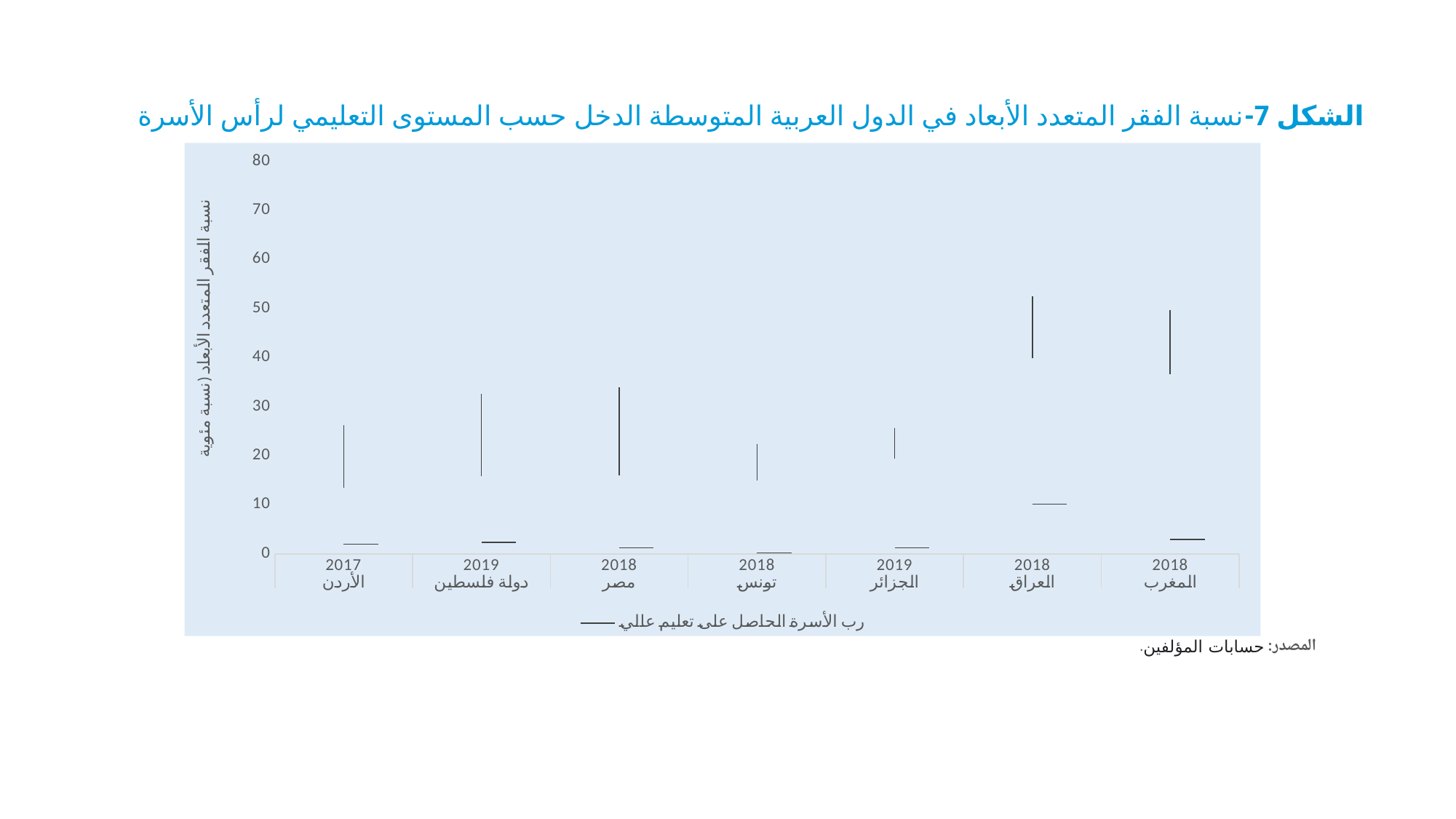
How many country categories are shown on the x axis of the chart? 7 What is the title of the chart? الشكل 7- نسبة الفقر المتعدد الأبعاد في الدول العربية المتوسطة الدخل حسب المستوى التعليمي لرأس الأسرة What year is shown under الأردن on the x axis? 2017 Is the top of the vertical range shown for العراق greater or less than 40? greater Is the top of the vertical range shown for مصر greater or less than 30? greater Which country has the highest value for the series رب الأسرة الحاصل على تعليم عالي? العراق Is the value for العراق for the series رب الأسرة الحاصل على تعليم عالي greater or less than 20? less Which is larger: the value for العراق or the value for الأردن for the series رب الأسرة الحاصل على تعليم عالي? العراق How many series does the chart's legend list? 1 What is the name of the series listed in the chart's legend? رب الأسرة الحاصل على تعليم عالي